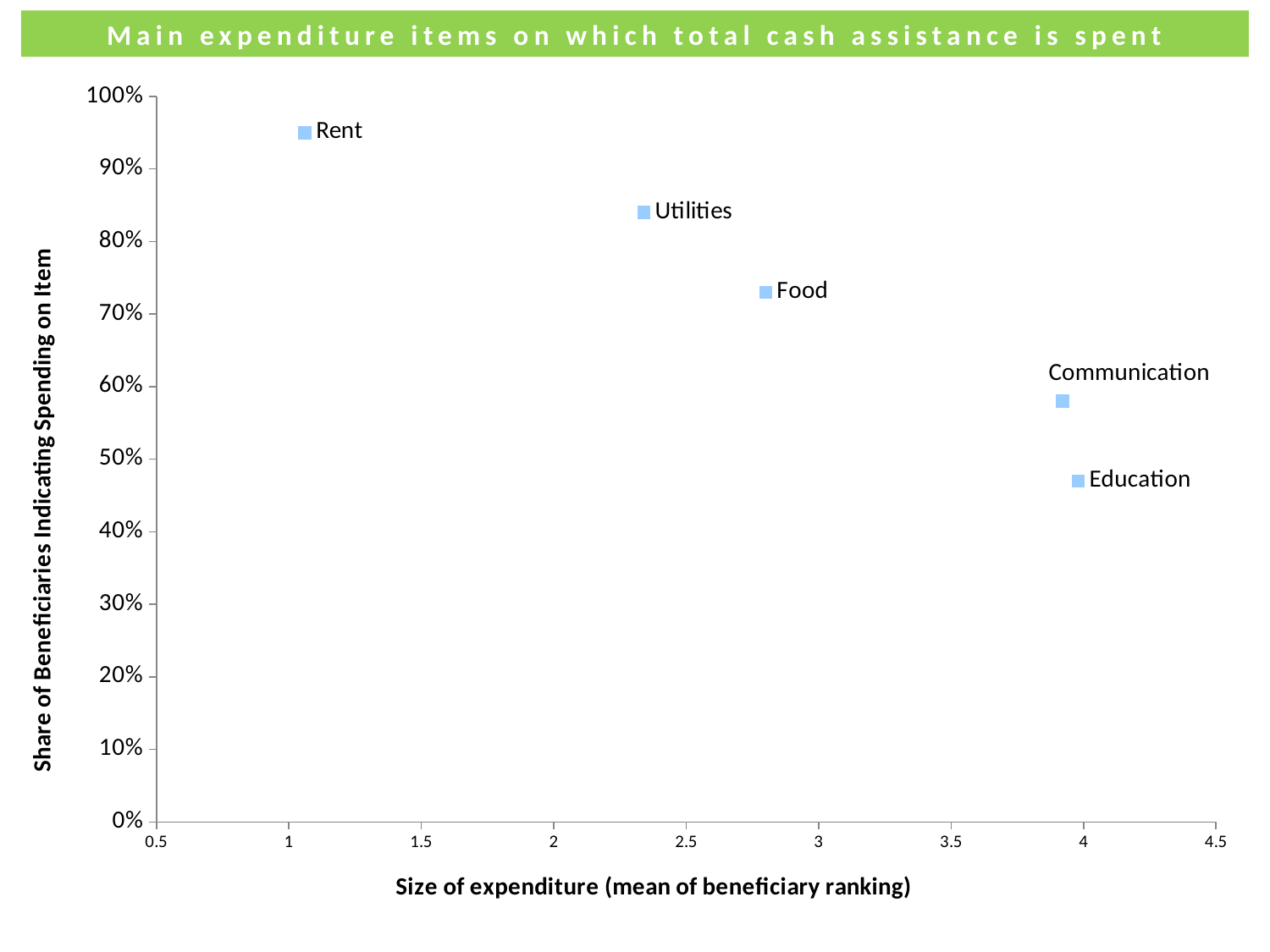
Is the share of beneficiaries for Utilities greater or less than 80%? greater What is the label of the x axis? Size of expenditure (mean of beneficiary ranking) Is the share of beneficiaries for Food greater or less than 70%? greater Is the share of beneficiaries for Communication greater or less than 60%? less Which expenditure item has the lowest share of beneficiaries indicating spending on it? Education Which has a higher share of beneficiaries indicating spending, Rent or Food? Rent As the size of expenditure (mean of beneficiary ranking) increases along the x axis, does the share of beneficiaries rise or fall? fall What kind of chart is shown on the slide? scatter chart How many expenditure items are plotted on the chart? 5 Which expenditure item has the highest share of beneficiaries indicating spending on it? Rent